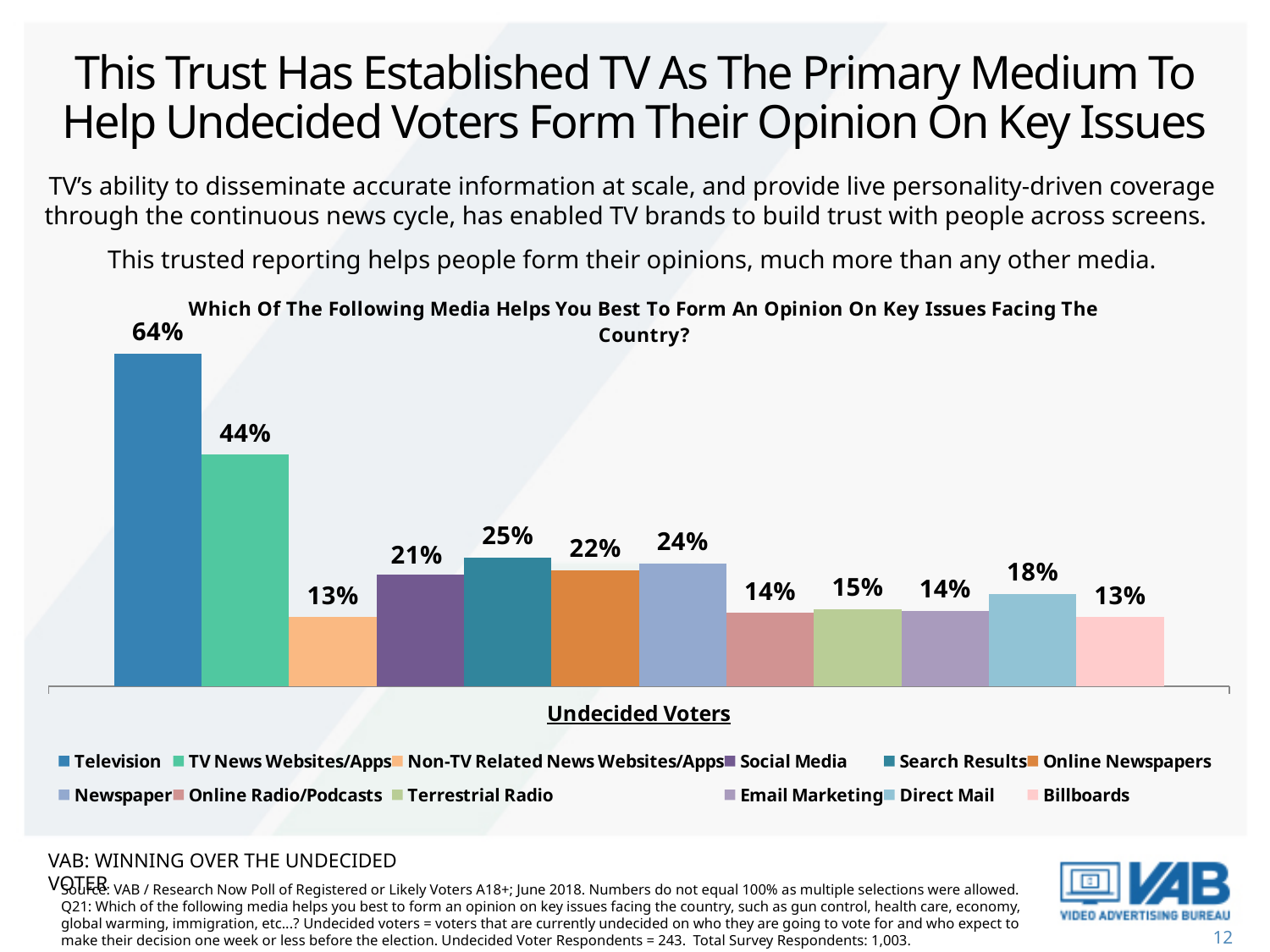
What is the difference between the values for Search Results and Billboards? 12% Which medium has the highest value in the chart? Television What is the difference between the values for Television and TV News Websites/Apps? 20% What kind of chart is shown on the slide? Bar chart What is the category label shown beneath the bars on the x axis? Undecided Voters What is the value shown for Direct Mail? 18% Which is larger, the value for Newspaper or the value for Online Newspapers? Newspaper Which is larger, the value for Social Media or the value for Terrestrial Radio? Social Media How many series does the legend list? 12 What is the value shown for TV News Websites/Apps? 44% What is the value shown for Search Results? 25% What percentage of undecided voters chose Television as the medium that helps them best form an opinion on key issues? 64%